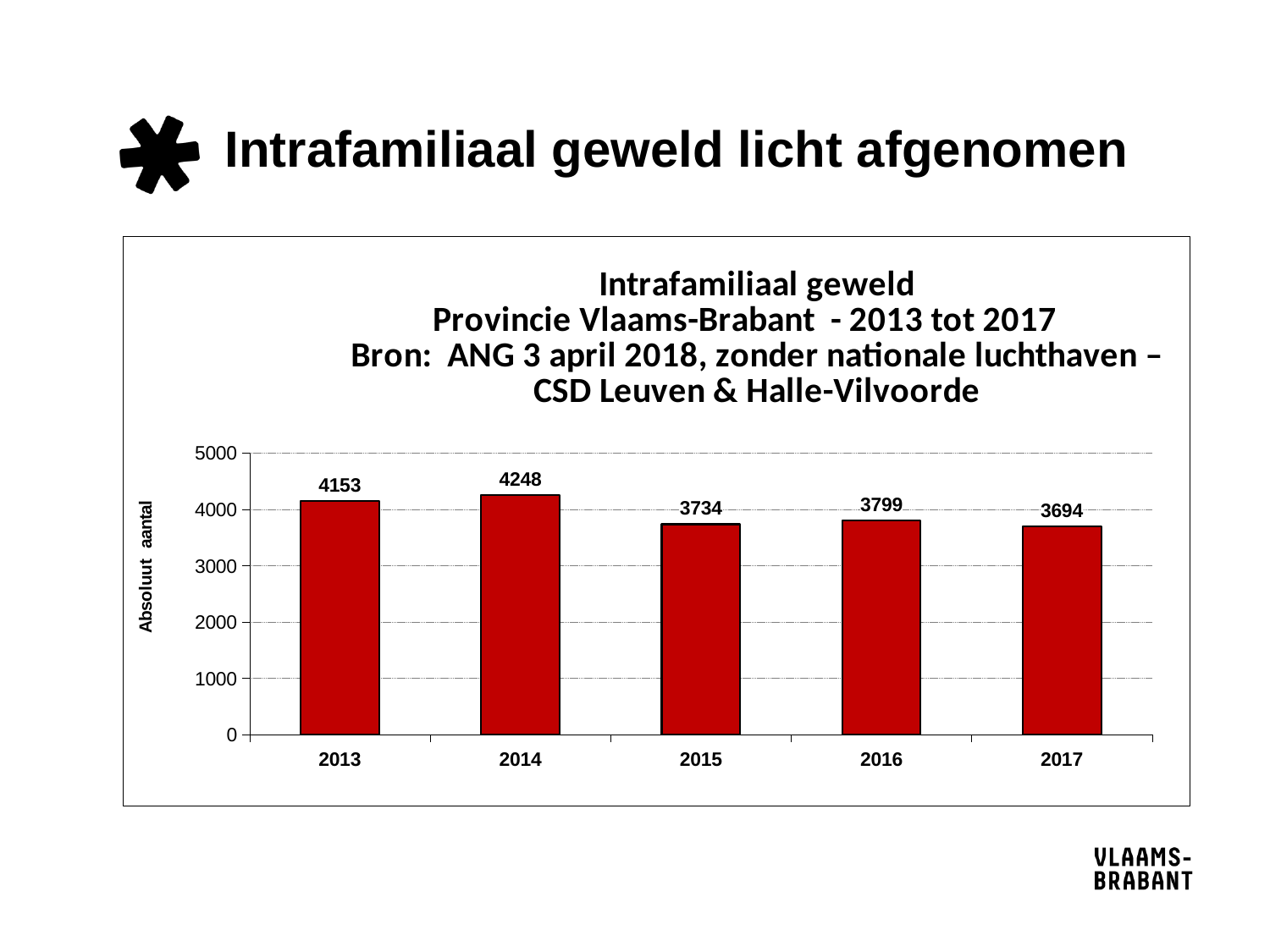
What is the value for 2015? 3734 What is the difference between the values for 2014 and 2013? 95 What kind of chart is shown? bar chart Which is larger, the value for 2015 or the value for 2016? 2016 Which year has the lowest value? 2017 What is the difference between the values for 2016 and 2017? 105 What is the label of the y axis? Absoluut aantal What is the value for 2013? 4153 Which year has the highest value? 2014 Is the value for 2014 greater or less than 4000? greater How many years are shown on the x axis? 5 What is the value for 2017? 3694